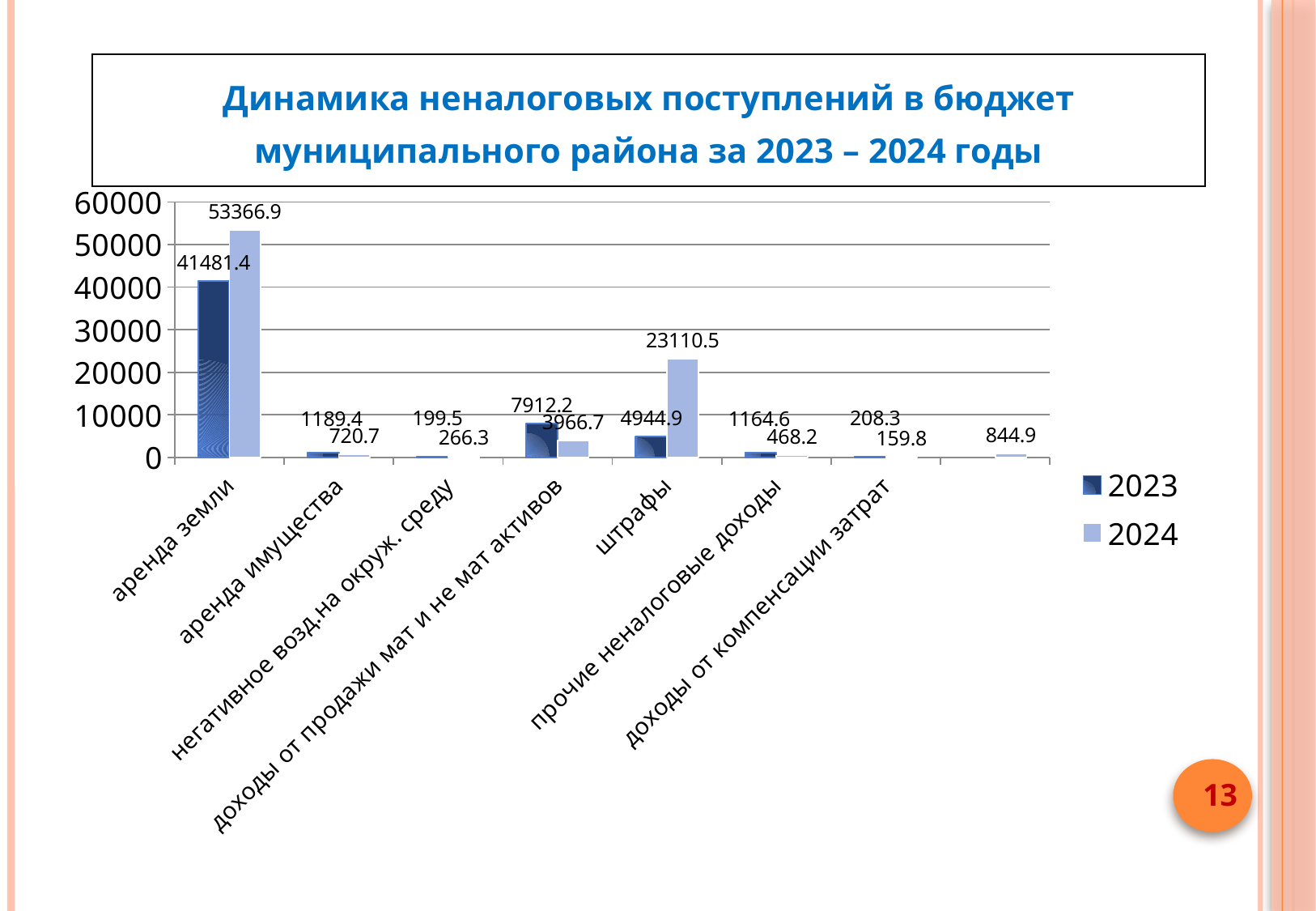
Which is larger for прочие неналоговые доходы: the 2023 value or the 2024 value? 2023 How many series does the legend list? 2 What is the 2024 value for доходы от продажи мат и не мат активов? 3966.7 What kind of chart is shown on the slide? bar chart By how much did штрафы increase from 2023 to 2024? 18165.6 Is the 2024 value for штрафы greater or less than 20000? greater Which labelled category has the lowest value in the 2023 series? негативное возд.на окруж. среду Which category has the highest value in the 2024 series? аренда земли What is the value for аренда земли in 2024? 53366.9 What is the difference between the 2024 and 2023 values for аренда земли? 11885.5 What is the 2023 value for доходы от компенсации затрат? 208.3 What is the value for штрафы in 2023? 4944.9